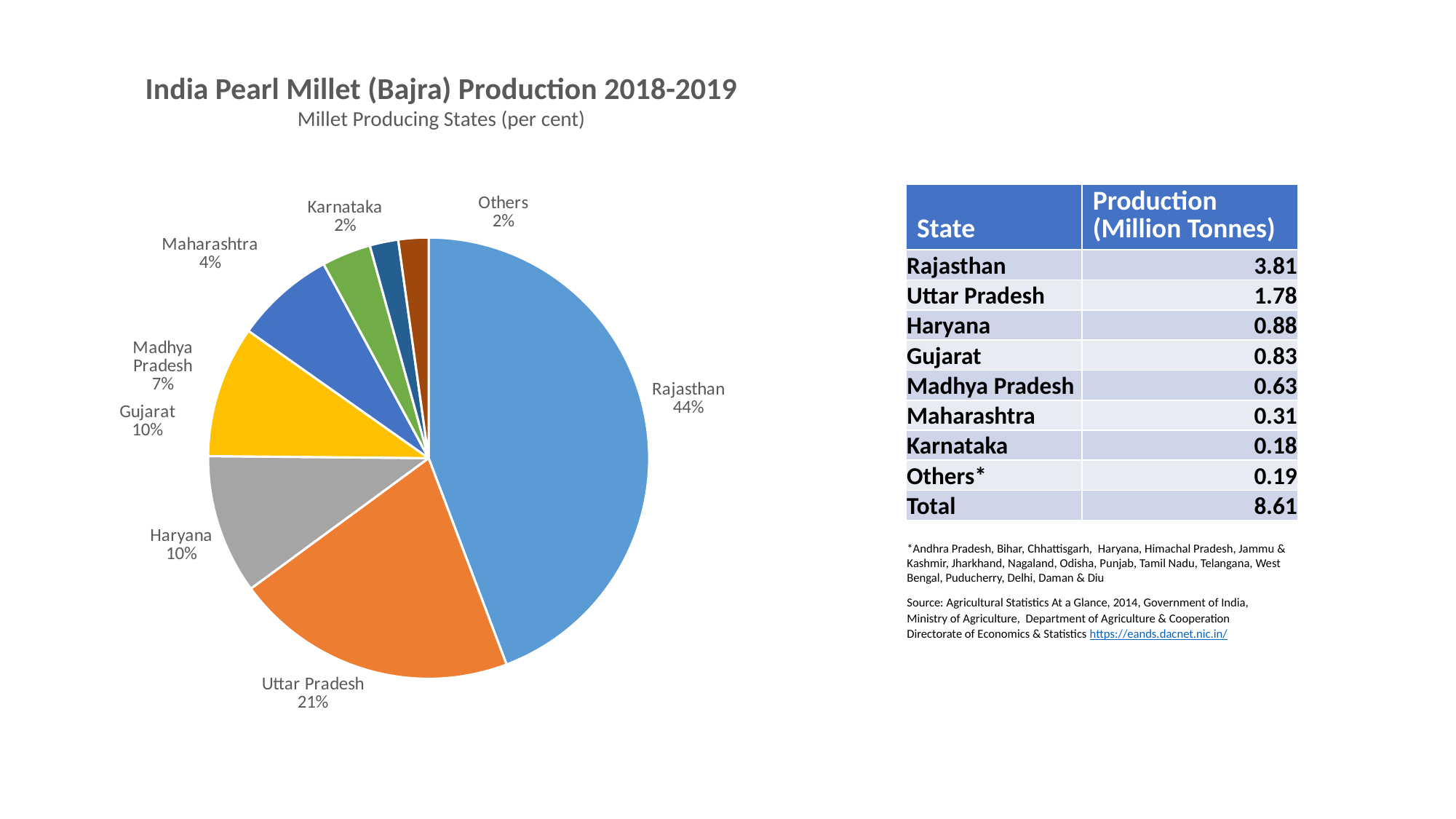
Which of the two, Gujarat or Madhya Pradesh, has the larger slice in the pie chart? Gujarat What colour is the Uttar Pradesh slice in the pie chart? Orange How many slices does the pie chart have? 8 Which state has the largest slice of the pie chart? Rajasthan What percentage is shown for Madhya Pradesh in the pie chart? 7% What share of the pie chart does Rajasthan hold? 44% What kind of chart is shown on the slide? Pie chart What percentage is shown for Karnataka in the pie chart? 2% What share of the pie chart does Uttar Pradesh hold? 21% What is the title of the chart? India Pearl Millet (Bajra) Production 2018-2019 What percentage is shown for Maharashtra in the pie chart? 4% What is the difference in percentage points between Rajasthan's and Uttar Pradesh's slices in the pie chart? 23